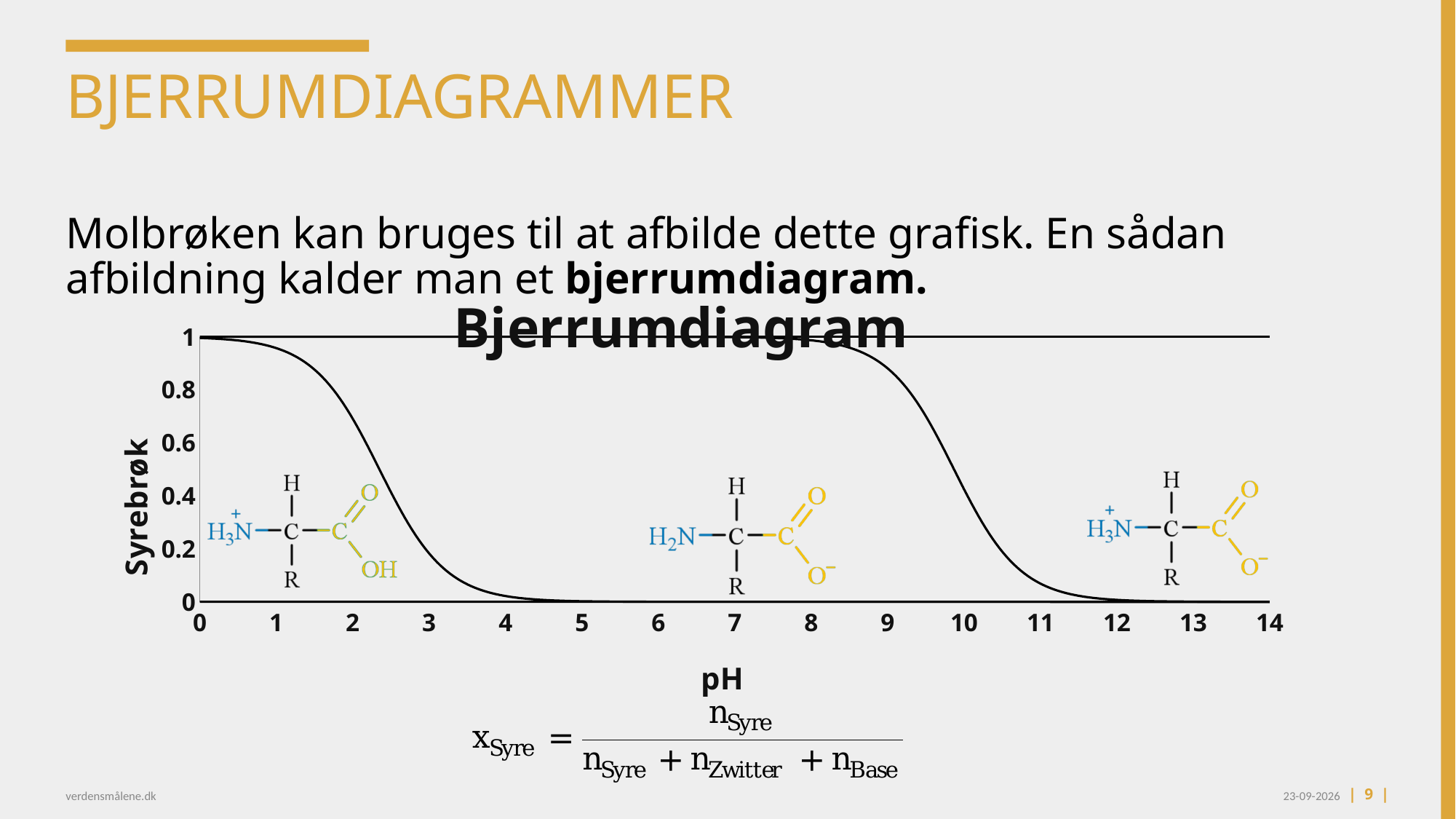
Is the value of the left-hand curve at pH 1 greater or less than 0.8? greater What is the label of the x axis of the chart? pH Is the value of the left-hand curve at pH 4 greater or less than 0.2? less Does the right-hand curve rise or fall as pH increases from 9 to 12? fall What is the highest value shown on the x axis of the chart? 14 Does the left-hand curve rise or fall as pH increases from 1 to 4? fall How many tick labels are shown on the x axis of the chart? 15 Is the value of the right-hand curve at pH 9 greater or less than 0.6? greater What is the highest value shown on the y axis of the chart? 1 What is the title of the chart? Bjerrumdiagram What kind of chart is shown on the slide? line chart